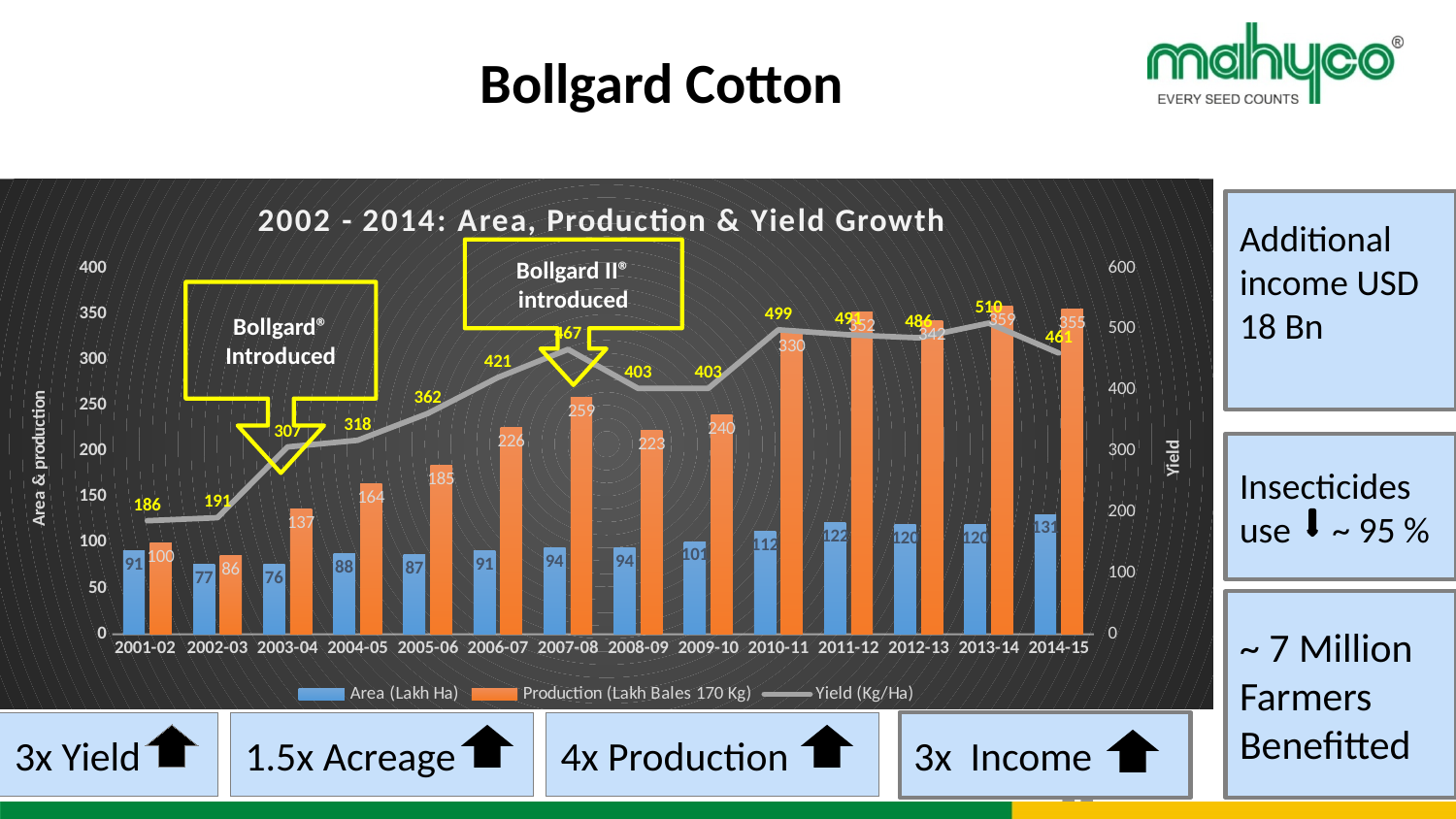
What is the Area (Lakh Ha) value for 2014-15? 131 What is the title of the chart? 2002 - 2014: Area, Production & Yield Growth What is the difference in Production (Lakh Bales 170 Kg) between 2010-11 and 2009-10? 90 Which year has the larger Area (Lakh Ha) value, 2009-10 or 2010-11? 2010-11 What is the Production (Lakh Bales 170 Kg) value for 2007-08? 259 Does the Yield (Kg/Ha) generally rise or fall from 2001-02 to 2013-14? Rise In which year is the Yield (Kg/Ha) highest? 2013-14 What kind of chart is shown on the slide? A combined bar and line chart What is the Yield (Kg/Ha) value for 2006-07? 421 How many series does the chart legend list? 3 In which year is Production (Lakh Bales 170 Kg) lowest? 2002-03 How many years (categories) are shown on the x axis of the chart? 14